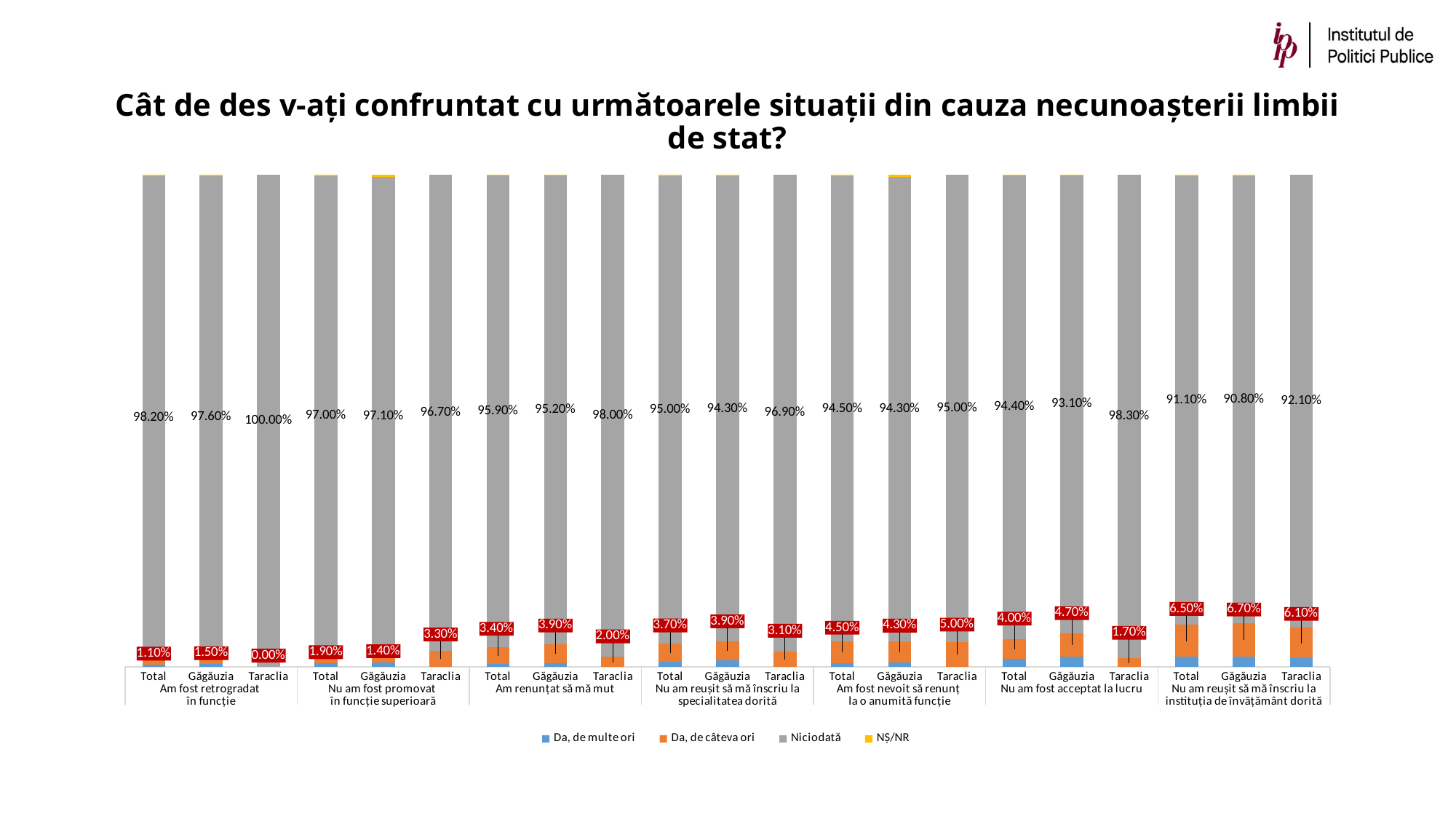
How many series does the legend list? 4 Which series is shown in yellow in the legend? NȘ/NR How many situation groups are shown along the x axis? 7 What is the 'Niciodată' value for Găgăuzia under 'Nu am fost acceptat la lucru'? 93.10% Which bar has the highest 'Niciodată' value on the chart? Taraclia, Am fost retrogradat în funcție (100.00%) Which bar has the lowest 'Niciodată' value on the chart? Găgăuzia, Nu am reușit să mă înscriu la instituția de învățământ dorită (90.80%) Under 'Am renunțat să mă mut', which has the larger 'Niciodată' value, Găgăuzia or Taraclia? Taraclia What kind of chart is shown on the slide? Stacked bar chart Under 'Nu am fost acceptat la lucru', what is the difference between the 'Niciodată' values for Taraclia and Total? 3.90% Under 'Am fost retrogradat în funcție', what is the difference between the 'Niciodată' values for Total and Găgăuzia? 0.60% What is the 'Niciodată' value for Total under 'Nu am reușit să mă înscriu la instituția de învățământ dorită'? 91.10% What is the 'Niciodată' value for Taraclia under 'Am fost retrogradat în funcție'? 100.00%